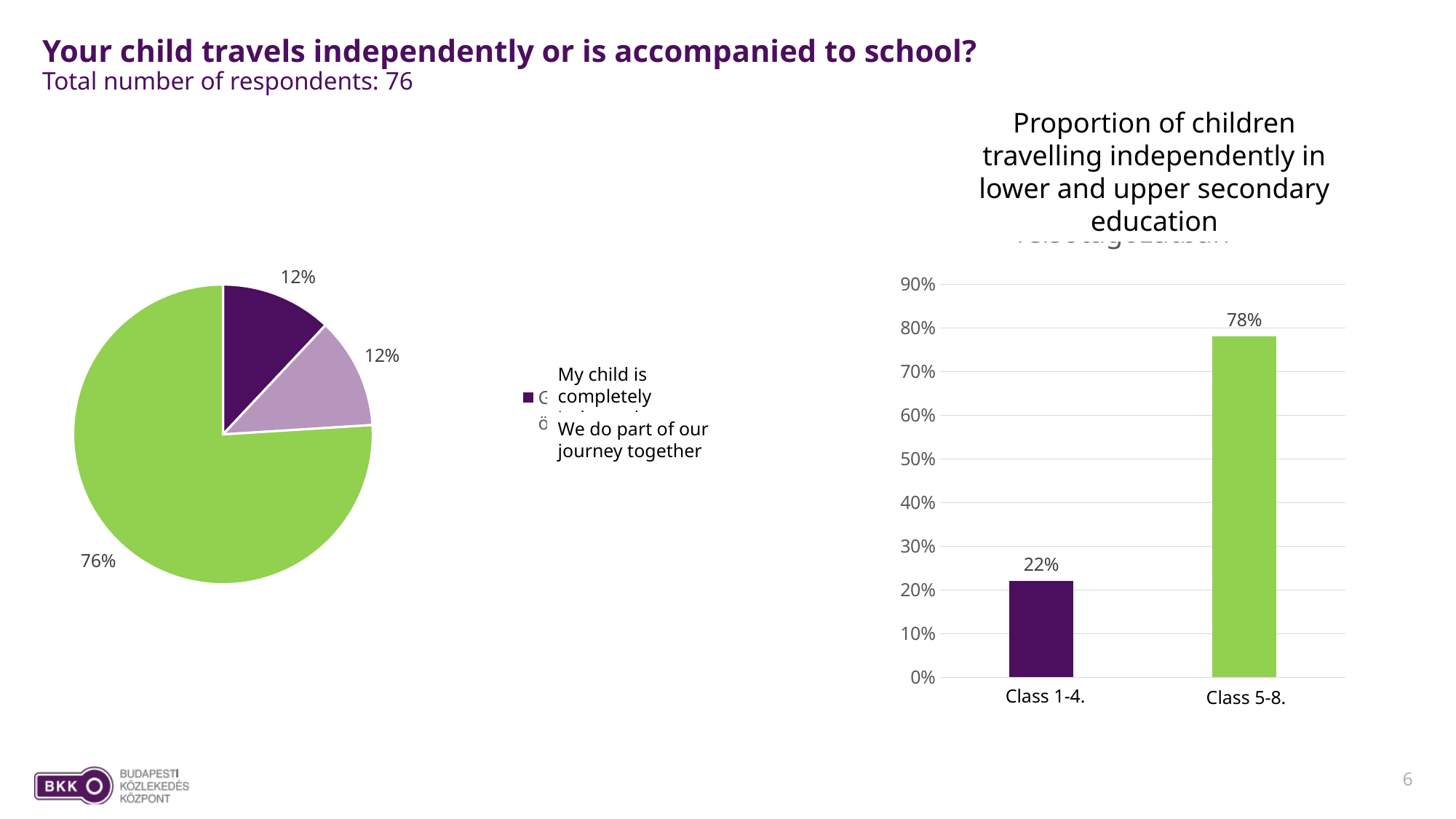
What is the title of the bar chart on the right? Proportion of children travelling independently in lower and upper secondary education In the bar chart on the right, what is the difference between the values for Class 5-8. and Class 1-4.? 56% In the bar chart on the right, which category has the lowest value? Class 1-4. In the bar chart on the right, how many categories are shown on the x axis? 2 In the bar chart on the right, what is the value for Class 5-8.? 78% In the bar chart on the right, is the value for Class 1-4. greater or less than 30%? less In the pie chart on the left, what is the share of the largest slice? 76% In the bar chart on the right, what is the value for Class 1-4.? 22% What kind of chart is the chart on the left of the slide? pie chart In the bar chart on the right, which category has the highest value? Class 5-8. In the pie chart on the left, how many slices are there? 3 What kind of chart is the chart on the right of the slide? bar chart